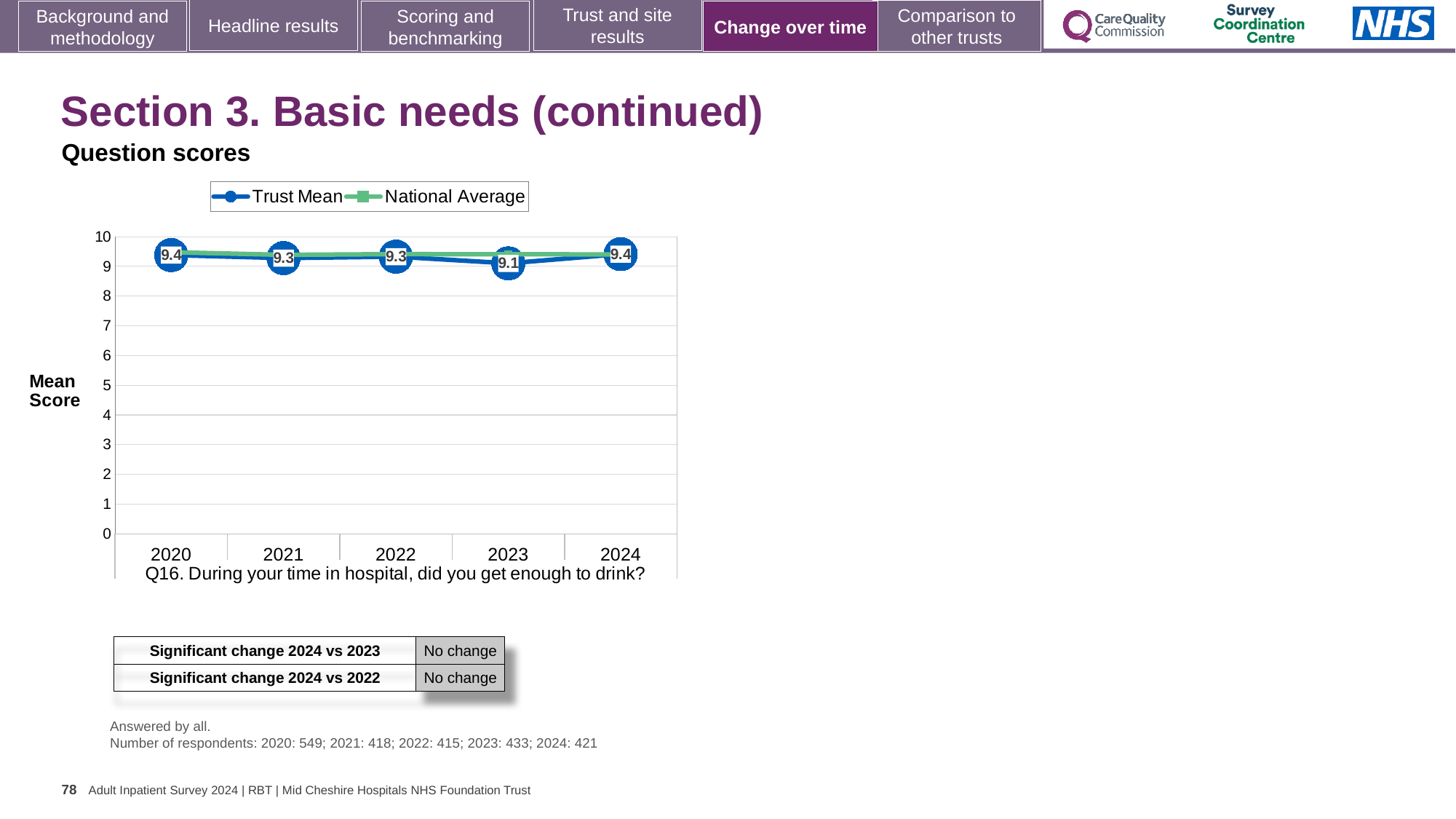
Is the Trust Mean value for 2023 greater or less than 8? greater In which year is the Trust Mean score lowest? 2023 Which year has the larger Trust Mean score, 2021 or 2023? 2021 What is the Trust Mean score for 2023? 9.1 How many series does the chart legend list? 2 What is the Trust Mean score for 2024? 9.4 What kind of chart is shown on the slide? line chart What is the difference between the Trust Mean scores for 2024 and 2023? 0.3 How many years are plotted on the x axis of the chart? 5 What is the Trust Mean score for 2020? 9.4 What are the two series named in the chart legend? Trust Mean and National Average Does the Trust Mean score rise or fall from 2023 to 2024? rise